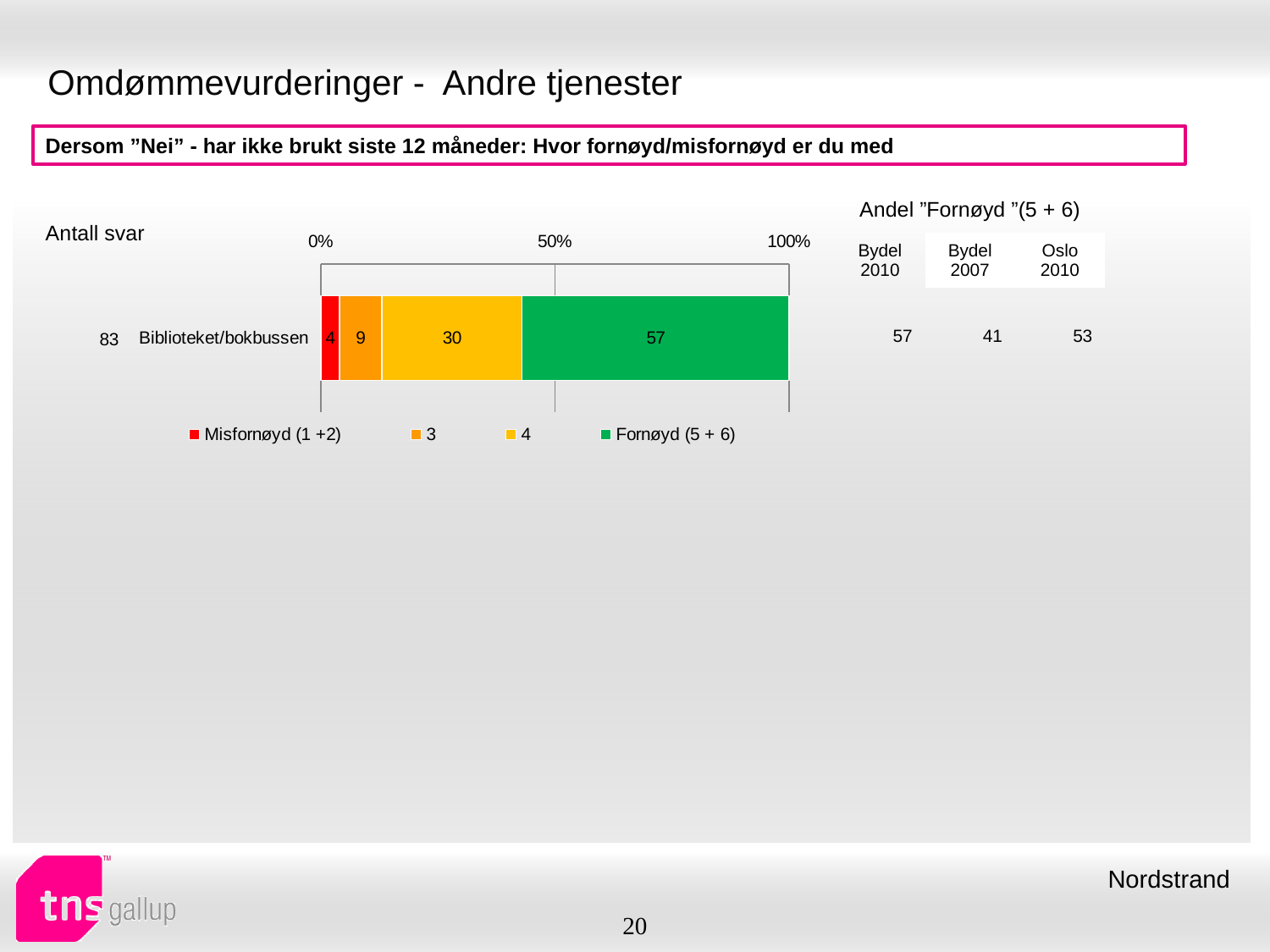
How many categories are plotted in the chart? 1 What is the value of the Fornøyd (5 + 6) segment for Biblioteket/bokbussen? 57 What is the value of the segment labelled 3 in the legend for Biblioteket/bokbussen? 9 What kind of chart is shown on the slide? Stacked bar chart Which segment of the Biblioteket/bokbussen bar has the smallest value? Misfornøyd (1 +2) What is the value of the segment labelled 4 in the legend for Biblioteket/bokbussen? 30 What is the total of all segments in the Biblioteket/bokbussen bar? 100 Which segment of the Biblioteket/bokbussen bar has the largest value? Fornøyd (5 + 6) What is the value of the Misfornøyd (1 +2) segment for Biblioteket/bokbussen? 4 How many series does the legend list? 4 Which is larger for Biblioteket/bokbussen: the segment labelled 3 or the segment labelled 4? 4 What is the difference between the Fornøyd (5 + 6) segment and the segment labelled 4 for Biblioteket/bokbussen? 27